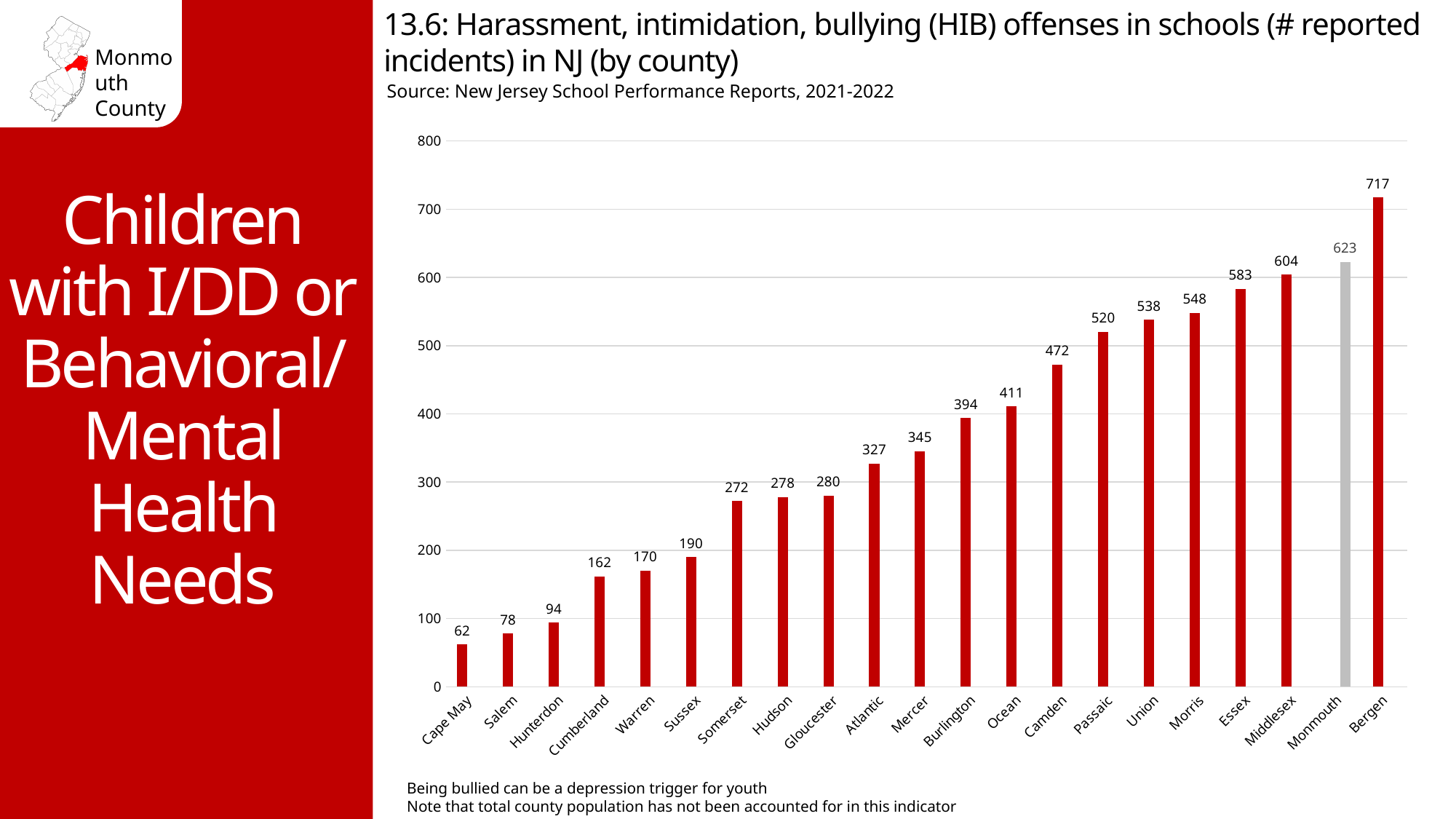
Which county has the highest number of reported HIB incidents? Bergen What is the number of reported HIB incidents for Monmouth? 623 Is the value for Camden greater or less than 500? less What is the number of reported HIB incidents for Cape May? 62 How many counties are shown on the chart? 21 Which county's bar is shown in grey rather than red? Monmouth What is the value shown for Burlington? 394 Which county has the lowest number of reported HIB incidents? Cape May What is the difference between the values for Bergen and Monmouth? 94 What kind of chart is shown on the slide? Bar chart What is the difference between the values for Middlesex and Essex? 21 Which has a higher value, Hudson or Gloucester? Gloucester